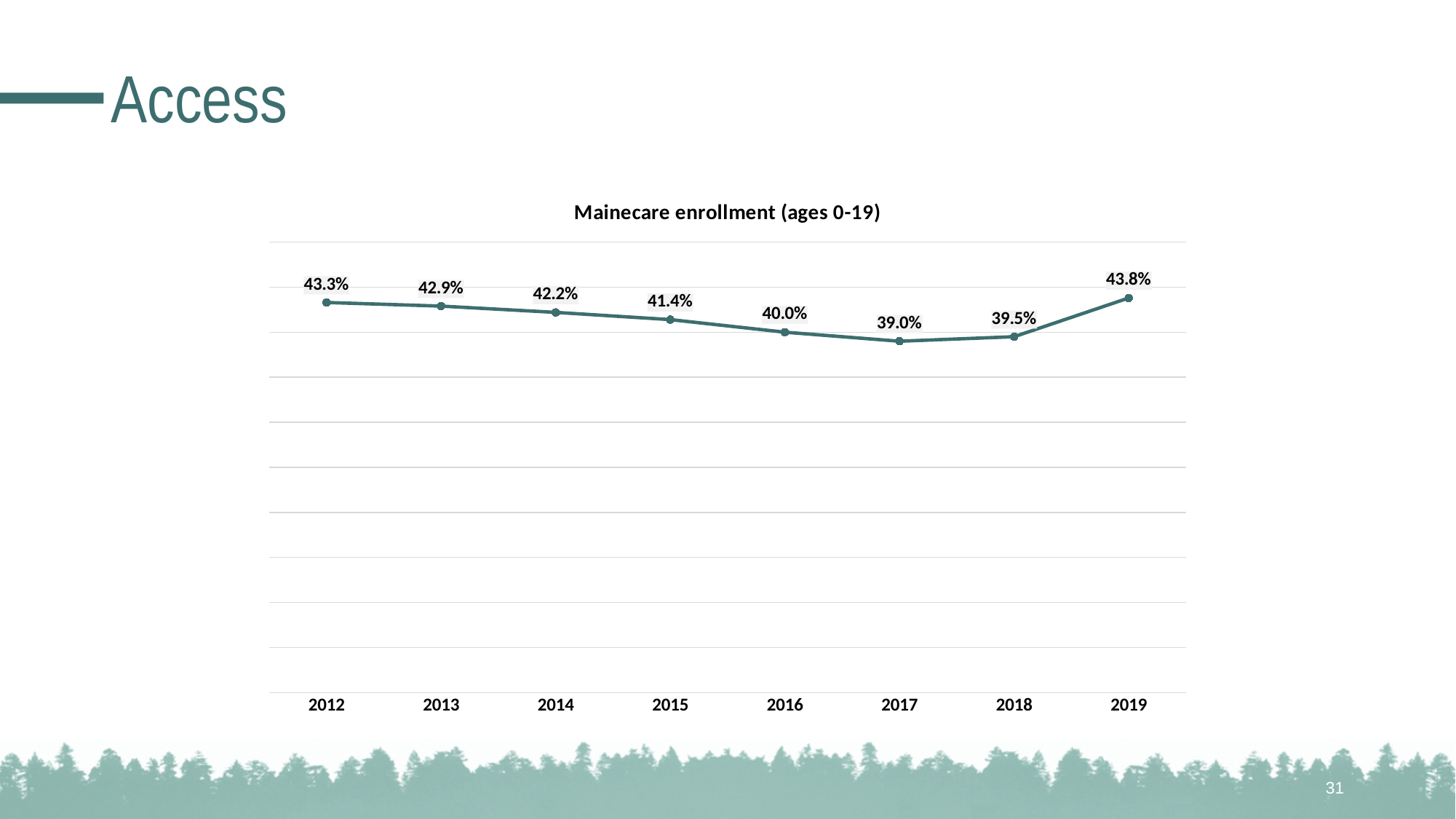
Which year has the lowest Mainecare enrollment (ages 0-19)? 2017 Do the Mainecare enrollment values rise or fall from 2012 to 2017? Fall What is the Mainecare enrollment (ages 0-19) value for 2017? 39.0% Which year has a higher Mainecare enrollment value, 2014 or 2016? 2014 What is the difference between the Mainecare enrollment values for 2019 and 2018? 4.3% What is the title of the chart on the slide? Mainecare enrollment (ages 0-19) What is the Mainecare enrollment (ages 0-19) value for 2019? 43.8% What kind of chart is used to show Mainecare enrollment (ages 0-19)? Line chart What is the Mainecare enrollment (ages 0-19) value for 2012? 43.3% Which year has the highest Mainecare enrollment (ages 0-19)? 2019 What is the difference between the Mainecare enrollment values for 2012 and 2017? 4.3% How many years are plotted in the Mainecare enrollment (ages 0-19) chart? 8